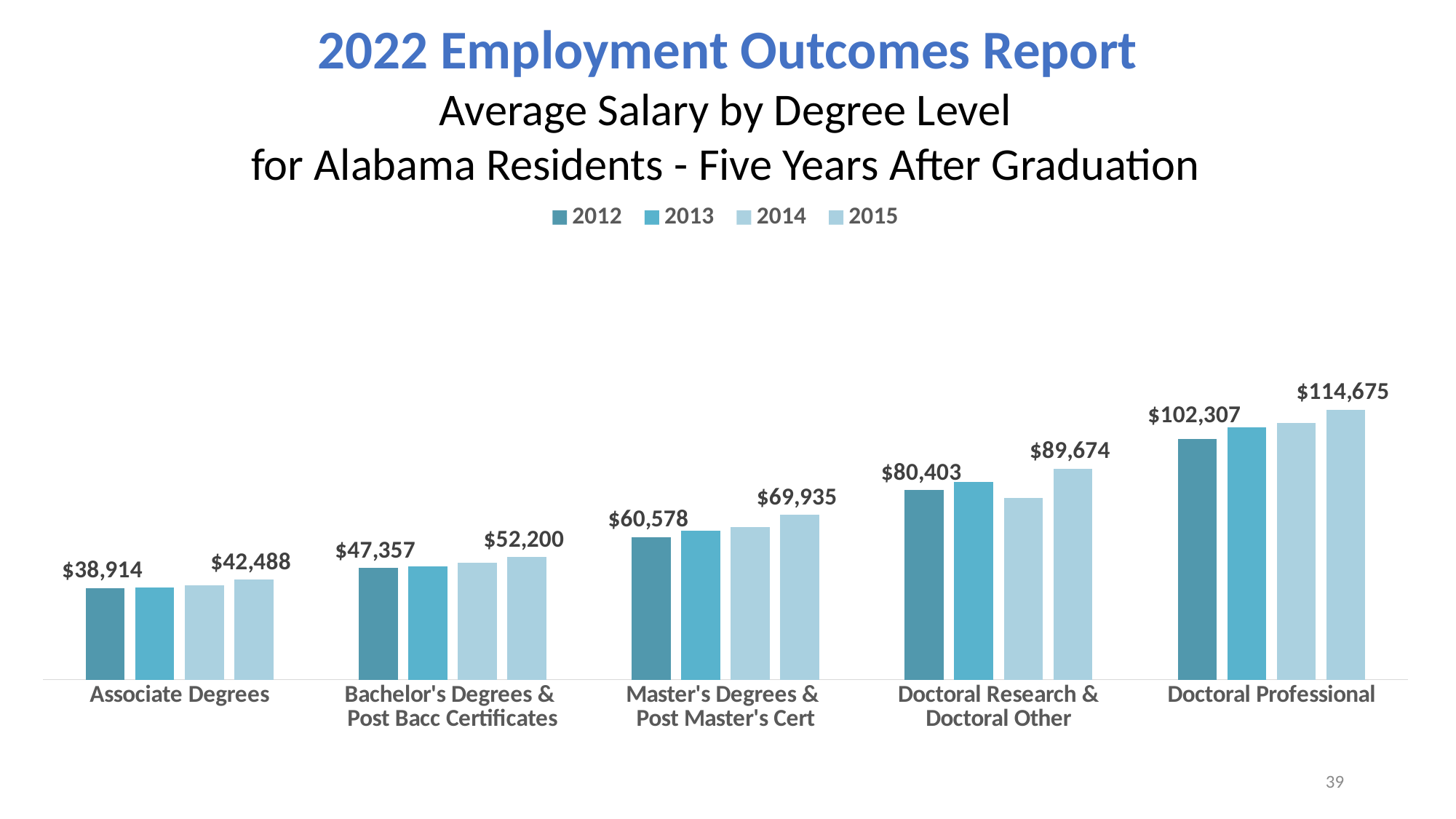
How much higher is the 2015 average salary than the 2012 average salary for Doctoral Professional degrees? $12,368 What is the 2012 average salary for Master's Degrees & Post Master's Cert? $60,578 How many degree level categories are shown on the x axis? 5 What is the 2015 average salary for Doctoral Professional degrees? $114,675 Which degree level has the highest 2015 average salary? Doctoral Professional Which degree level has the lowest 2012 average salary? Associate Degrees How many years does the legend list? 4 What type of chart is shown on the slide? Bar chart What is the 2012 average salary for Doctoral Research & Doctoral Other? $80,403 Which is larger: the 2015 salary for Master's Degrees & Post Master's Cert or the 2012 salary for Doctoral Research & Doctoral Other? 2012 salary for Doctoral Research & Doctoral Other What is the 2015 average salary for Bachelor's Degrees & Post Bacc Certificates? $52,200 What is the 2012 average salary for Associate Degrees? $38,914